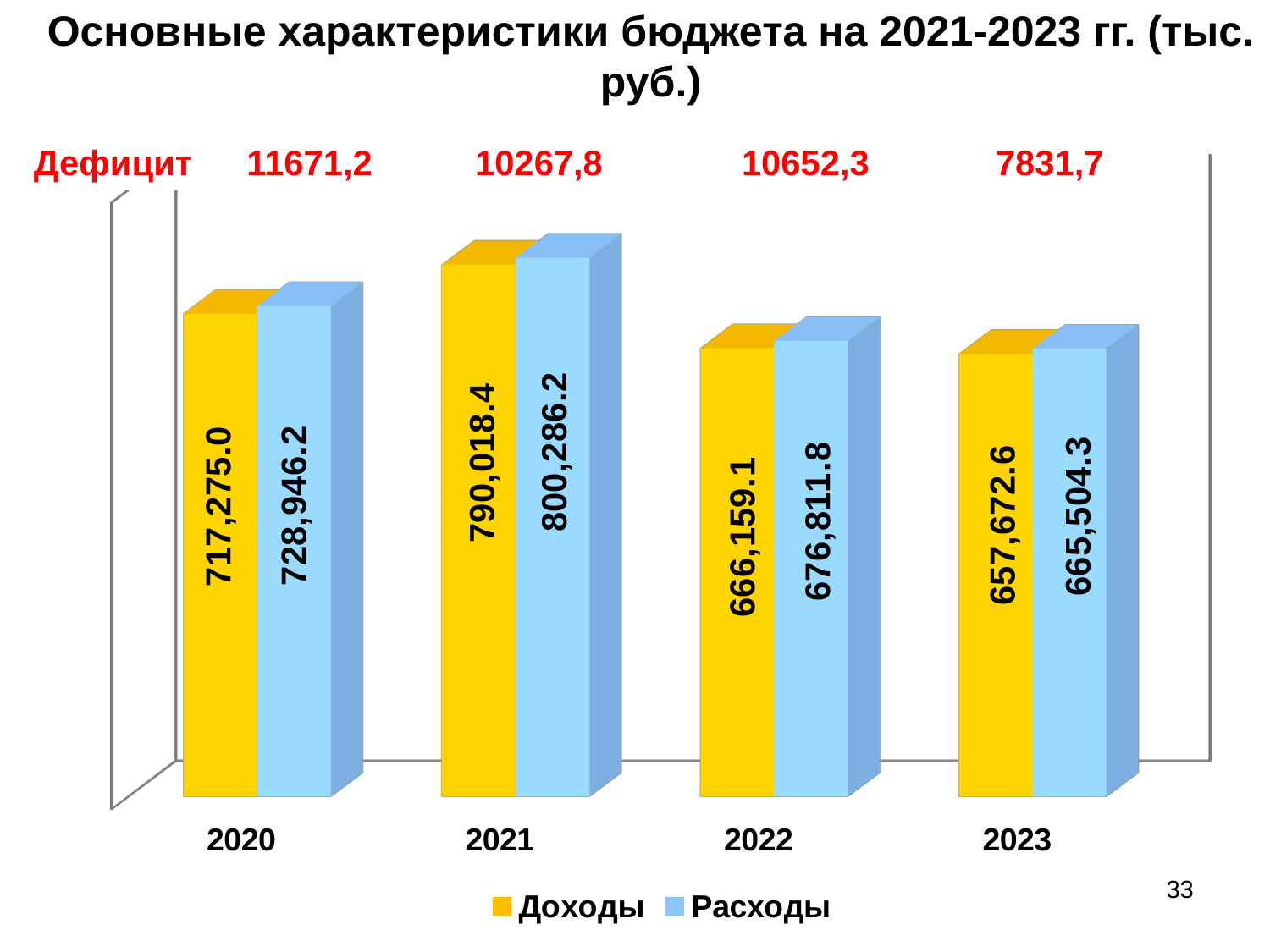
How many series does the legend list? 2 In which year is Расходы the lowest? 2023 How many years are shown on the x axis? 4 What is the value of Расходы for 2020? 728,946.2 What kind of chart is shown on the slide? Bar chart What is the value of Доходы for 2021? 790,018.4 What is the value of Расходы for 2022? 676,811.8 Which is larger in 2022, Доходы or Расходы? Расходы In which year is Доходы the highest? 2021 What is the difference between Расходы and Доходы in 2020? 11,671.2 Do the Доходы values rise or fall from 2021 to 2023? Fall What is the value of Доходы for 2023? 657,672.6